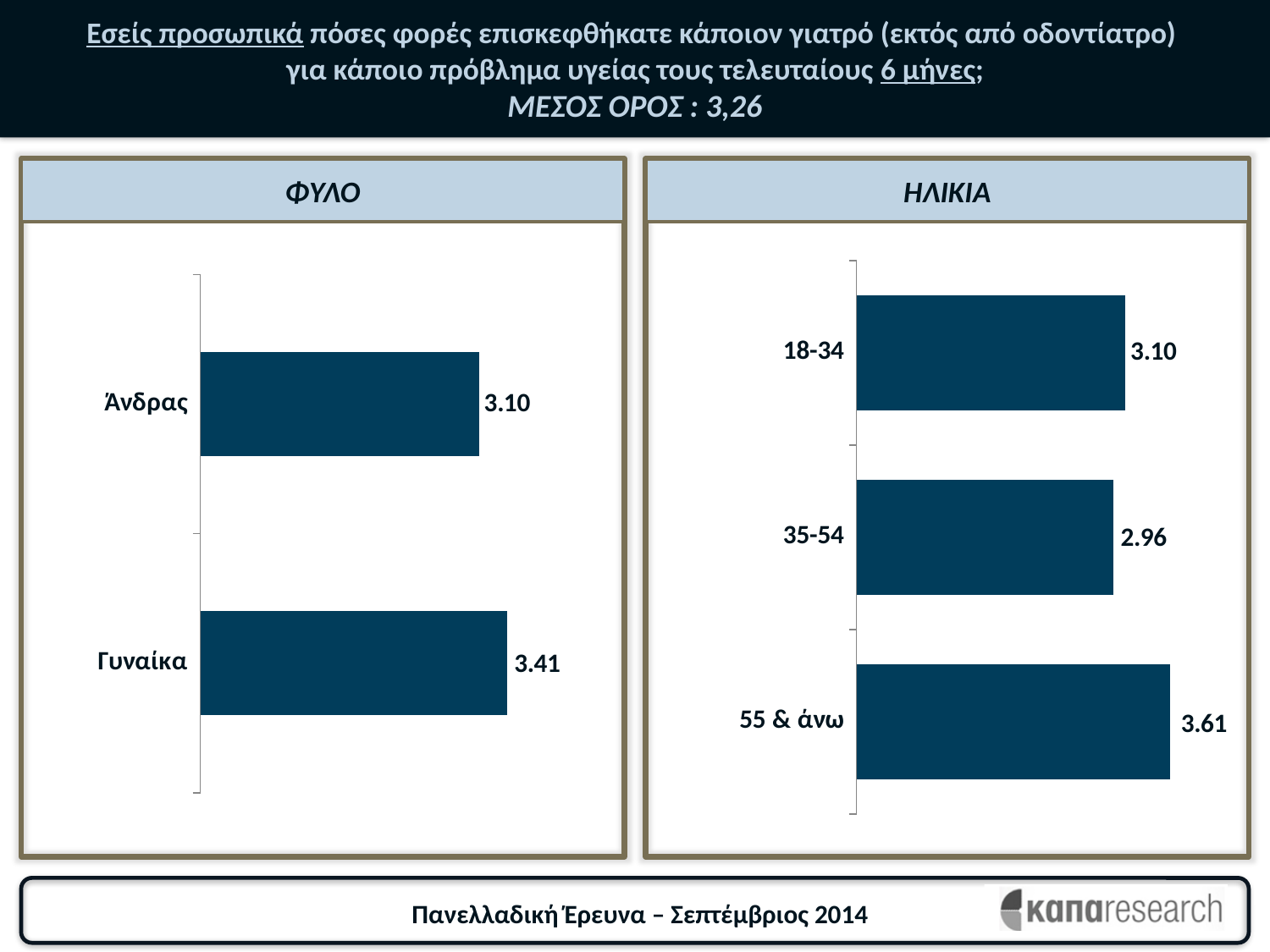
In the ΗΛΙΚΙΑ chart, which age group has the lowest value? 35-54 In the ΦΥΛΟ chart, what is the value for Άνδρας? 3.10 In the ΦΥΛΟ chart, which category has the higher value? Γυναίκα In the ΗΛΙΚΙΑ chart, how many age categories are shown? 3 In the ΦΥΛΟ chart, what is the value for Γυναίκα? 3.41 In the ΦΥΛΟ chart, what is the difference between the values for Γυναίκα and Άνδρας? 0.31 In the ΗΛΙΚΙΑ chart, what is the value for 55 & άνω? 3.61 What kind of chart is the ΗΛΙΚΙΑ chart? Bar chart In the ΗΛΙΚΙΑ chart, what is the value for 35-54? 2.96 In the ΗΛΙΚΙΑ chart, what is the difference between the values for 55 & άνω and 35-54? 0.65 In the ΗΛΙΚΙΑ chart, is the value for 18-34 larger or smaller than the value for 35-54? Larger In the ΗΛΙΚΙΑ chart, which age group has the highest value? 55 & άνω